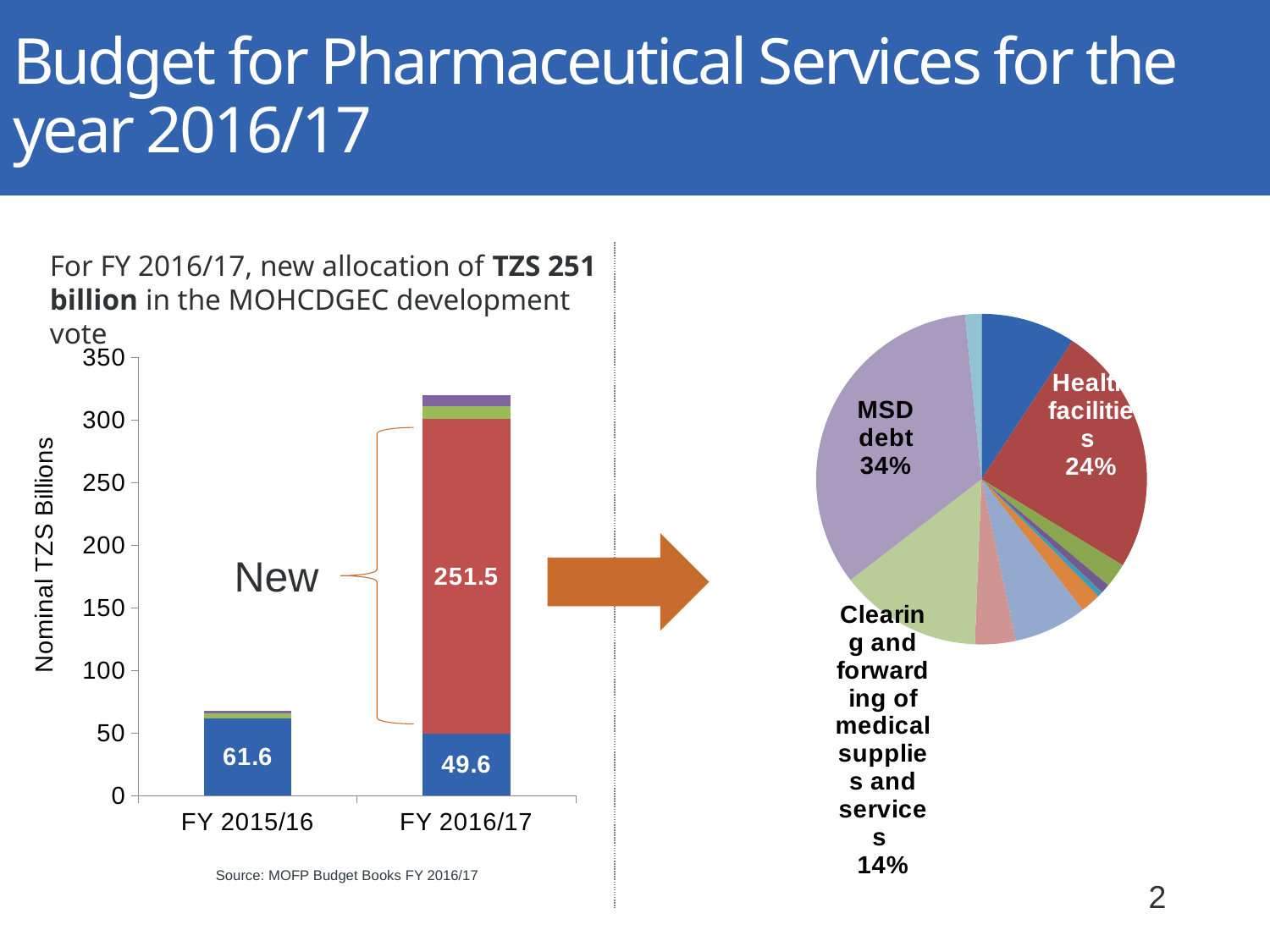
In the pie chart on the right, what share is labelled for Clearing and forwarding of medical supplies and services? 14% In the bar chart on the left, is the total height of the FY 2016/17 bar greater or less than 300? greater In the bar chart on the left, what is the value of the red segment labelled 'New' for FY 2016/17? 251.5 How many fiscal years are shown on the x axis of the bar chart on the left? 2 In the pie chart on the right, what share is labelled for MSD debt? 34% In the bar chart on the left, what is the value of the blue segment for FY 2015/16? 61.6 In the pie chart on the right, what share is labelled for Health facilities? 24% In the bar chart on the left, what is the value of the blue segment for FY 2016/17? 49.6 What is the title of the vertical axis of the bar chart on the left? Nominal TZS Billions In the bar chart on the left, what is the difference between the red segment (251.5) and the blue segment (49.6) for FY 2016/17? 201.9 In the bar chart on the left, is the blue segment larger for FY 2015/16 or FY 2016/17? FY 2015/16 In the bar chart on the left, is the total height of the FY 2015/16 bar greater or less than 100? less